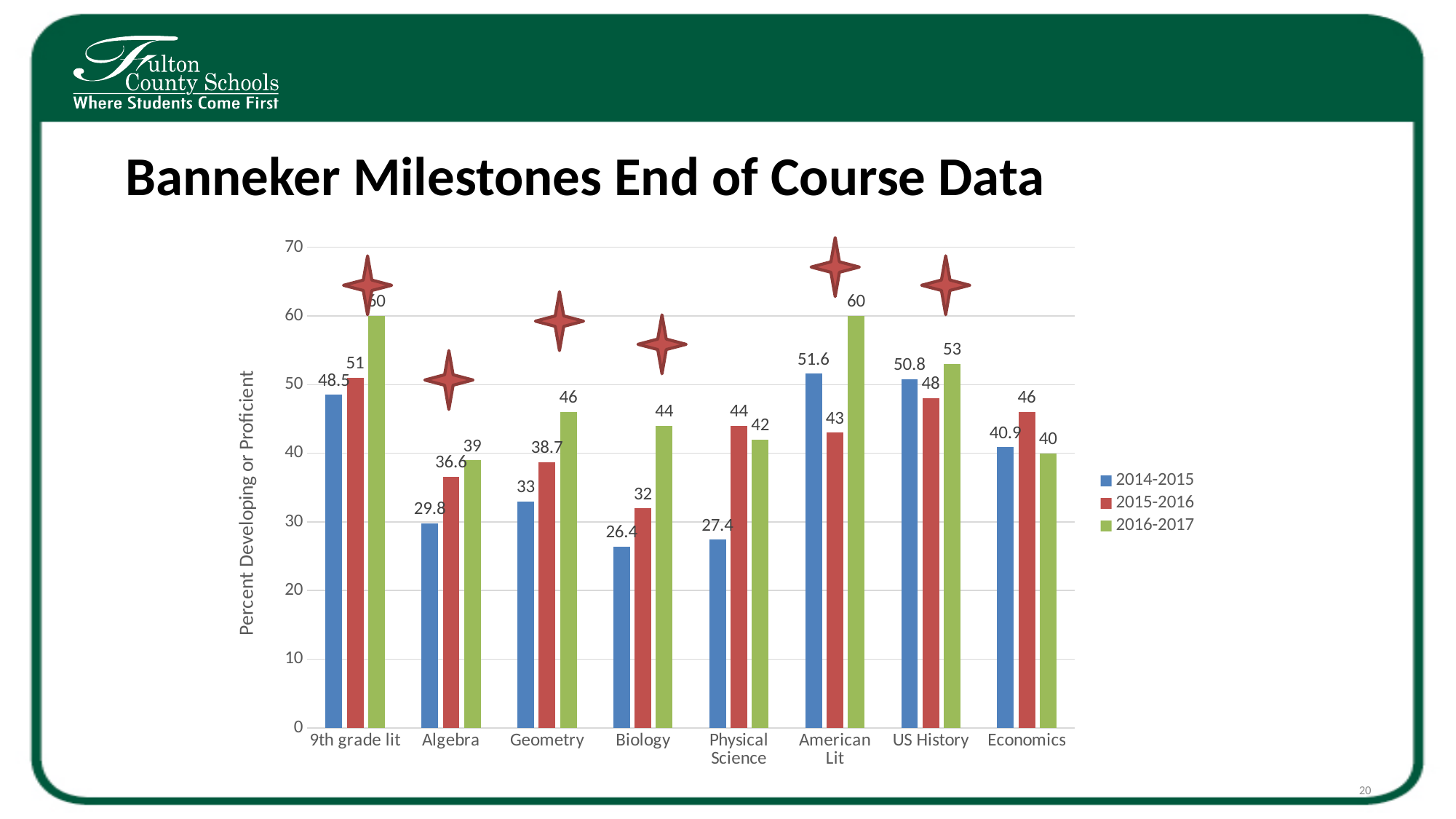
What is the 2014-2015 value for Algebra? 29.8 What is the 2016-2017 value for Biology? 44 What kind of chart is shown on the slide? bar chart How many courses are shown on the x axis? 8 Which course has the highest 2015-2016 value? 9th grade lit What is the difference between the 2016-2017 and 2014-2015 values for Biology? 17.6 What is the label of the vertical axis? Percent Developing or Proficient How many series does the legend list? 3 Is the 2014-2015 value for Physical Science greater or less than 30? less What is the 2015-2016 value for Geometry? 38.7 Which course has the lowest 2014-2015 value? Biology Which is larger for Economics, the 2015-2016 value or the 2016-2017 value? 2015-2016